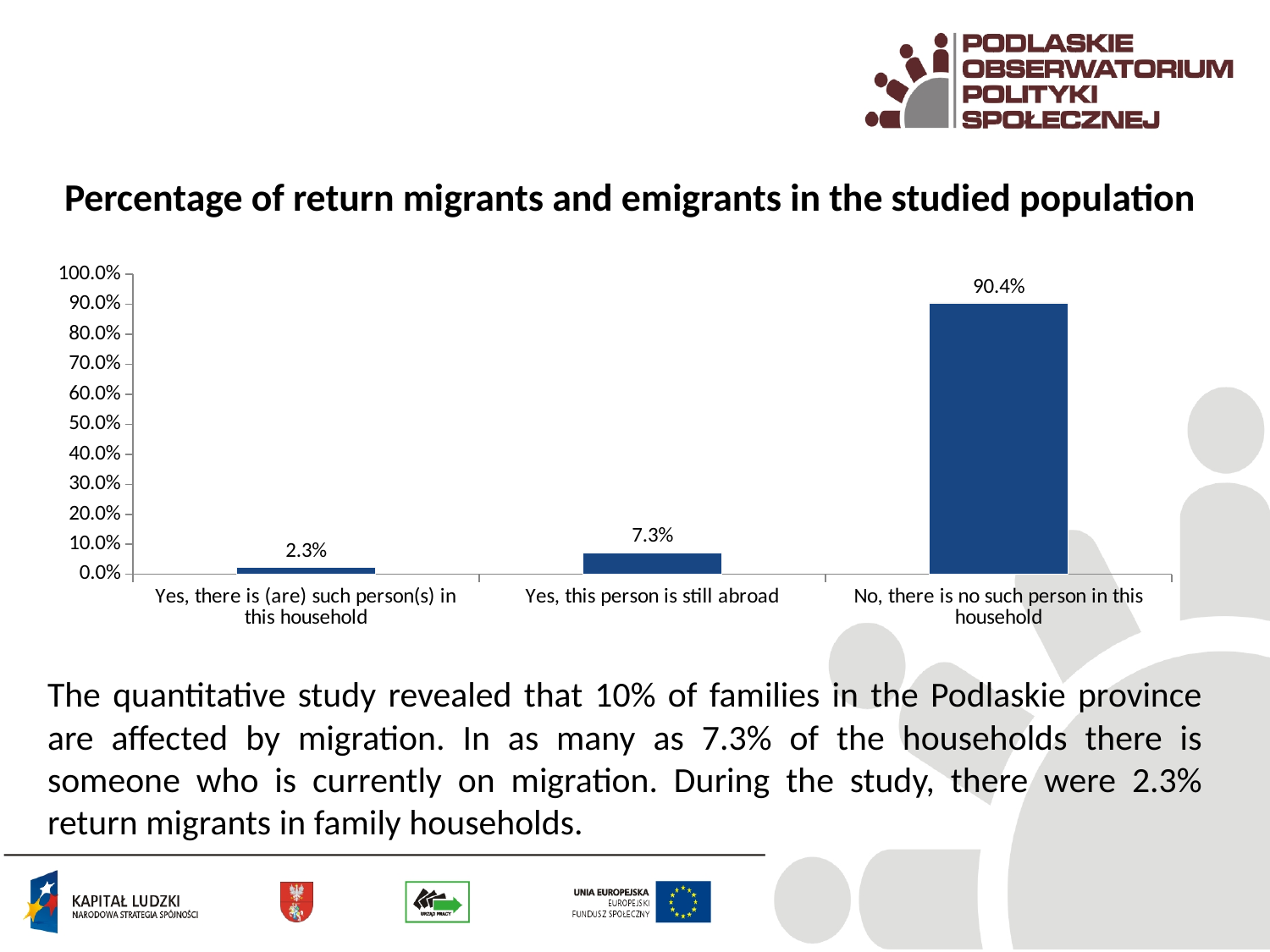
What is the value for "No, there is no such person in this household"? 90.4% Which category has the lowest value? Yes, there is (are) such person(s) in this household What is the title of the chart? Percentage of return migrants and emigrants in the studied population How many categories are shown on the x axis? 3 Which category has the highest value? No, there is no such person in this household What is the value for "Yes, there is (are) such person(s) in this household"? 2.3% Which is larger: the value for "Yes, this person is still abroad" or for "Yes, there is (are) such person(s) in this household"? Yes, this person is still abroad Is the value for "No, there is no such person in this household" greater or less than 80.0%? greater What is the difference between the values for "Yes, this person is still abroad" and "Yes, there is (are) such person(s) in this household"? 5.0% What is the difference between the values for "No, there is no such person in this household" and "Yes, this person is still abroad"? 83.1% What is the value for "Yes, this person is still abroad"? 7.3% What kind of chart is shown on the slide? Bar chart